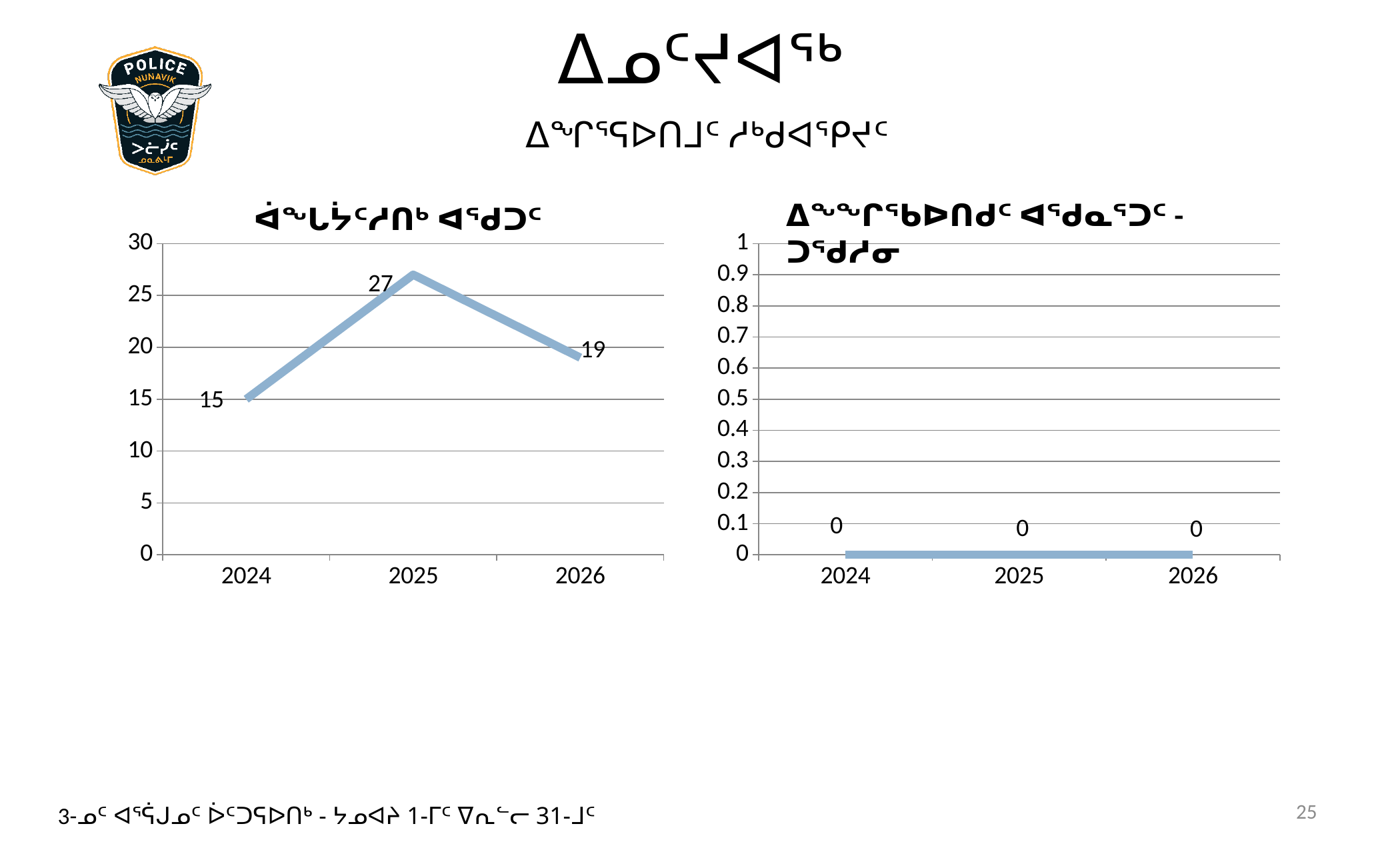
In the left chart, which year has the highest value? 2025 In the left chart, what is the value for 2026? 19 In the left chart, does the value rise or fall from 2025 to 2026? fall How many years are plotted on the x axis of the left chart? 3 In the left chart, what is the value for 2025? 27 In the left chart, what is the difference between the values for 2025 and 2024? 12 What kind of chart is the left chart? line chart In the left chart, what is the value for 2024? 15 In the right chart, what is the highest value shown on the y axis? 1 In the right chart, what is the value for 2025? 0 In the left chart, which year has the lowest value? 2024 In the left chart, which is larger, the value for 2026 or the value for 2024? 2026